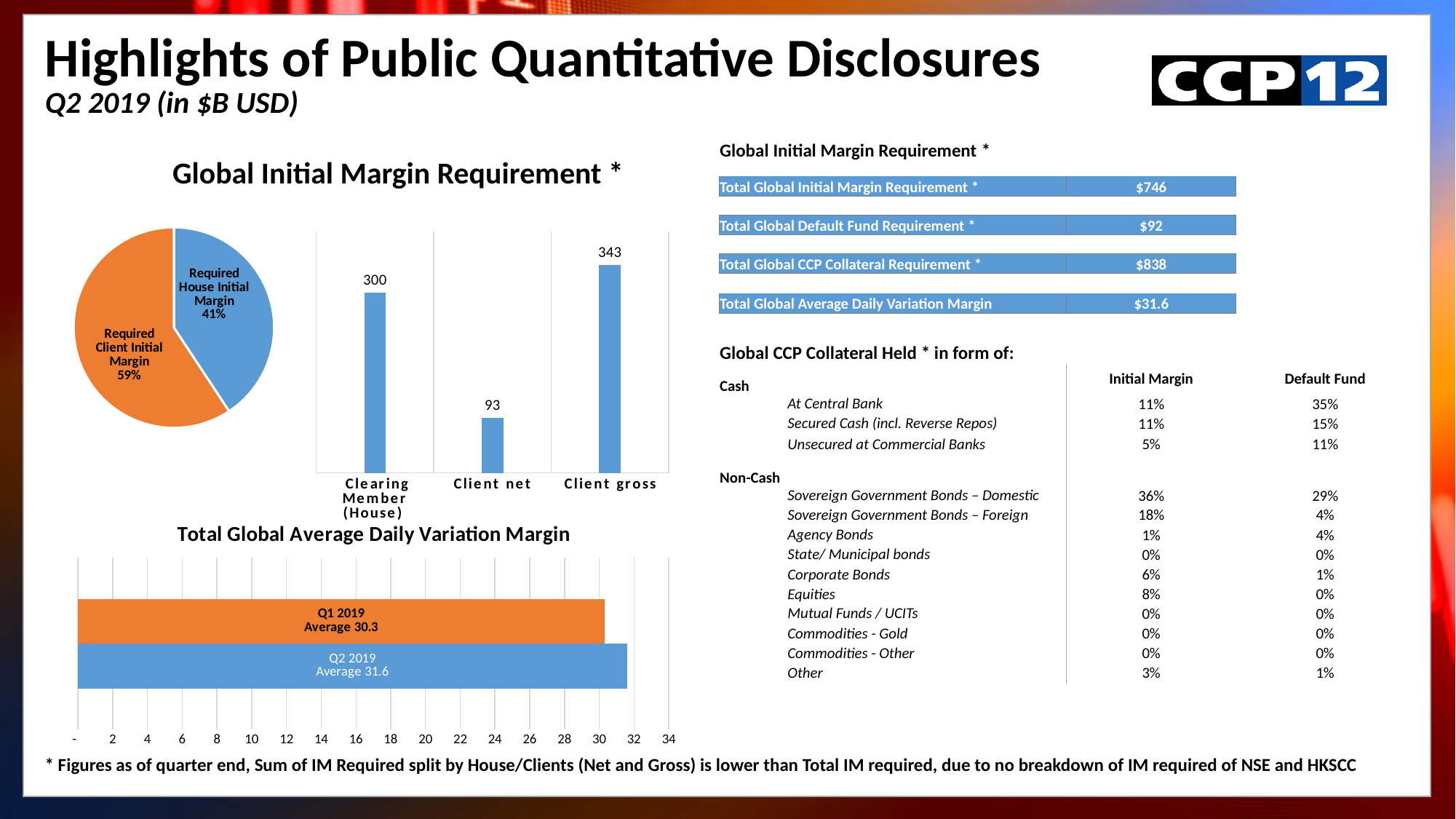
In the Total Global Average Daily Variation Margin chart, what is the average for Q2 2019? 31.6 In the Global Initial Margin Requirement pie chart, what share is Required House Initial Margin? 41% In the Global Initial Margin Requirement bar chart, what is the difference between Client gross and Clearing Member (House)? 43 In the Global Initial Margin Requirement pie chart, what share is Required Client Initial Margin? 59% How many categories are shown in the Global Initial Margin Requirement bar chart? 3 In the Global Initial Margin Requirement bar chart, what is the value for Client gross? 343 In the Global Initial Margin Requirement bar chart, which category has the highest value? Client gross In the Global Initial Margin Requirement pie chart, which slice is larger, Required Client Initial Margin or Required House Initial Margin? Required Client Initial Margin In the Global Initial Margin Requirement bar chart, what is the value for Clearing Member (House)? 300 In the Total Global Average Daily Variation Margin chart, what is the difference between the Q2 2019 and Q1 2019 averages? 1.3 What kind of chart is the Total Global Average Daily Variation Margin chart? Bar chart In the Global Initial Margin Requirement bar chart, which category has the lowest value? Client net